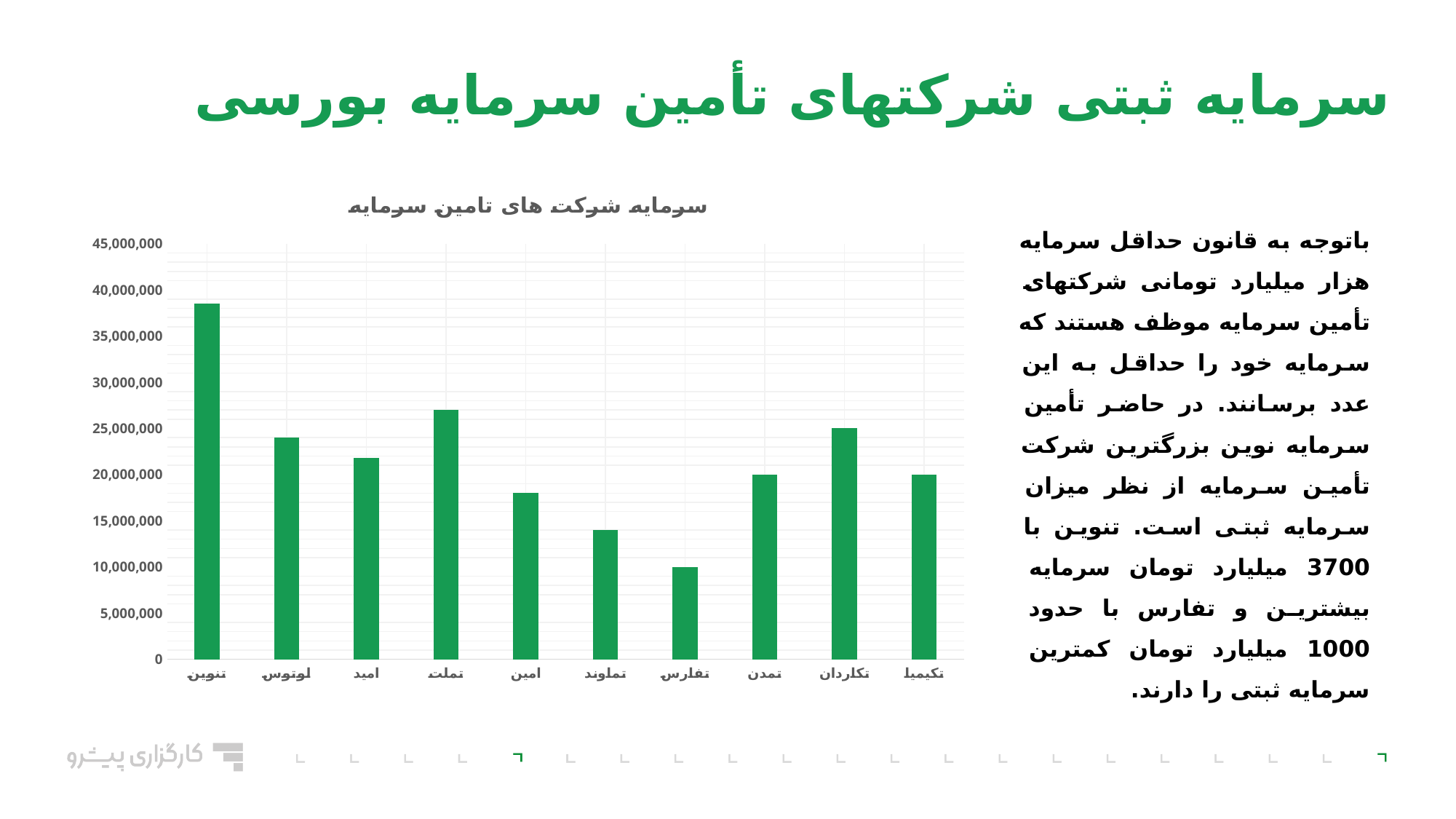
Which company has the lowest registered capital in the chart? تفارس How many companies (categories) are shown on the x axis of the chart? 10 Is the value for امین greater or less than 20,000,000? less Is the value for تکاردان greater or less than 20,000,000? greater Is the value for تنوین greater or less than 35,000,000? greater What kind of chart is shown on the slide? bar chart Which company has the highest registered capital in the chart? تنوین Which is larger, the value for تملت or the value for لوتوس? تملت What is the title of the chart? سرمایه شرکت های تامین سرمایه Which is larger, the value for امید or the value for امین? امید